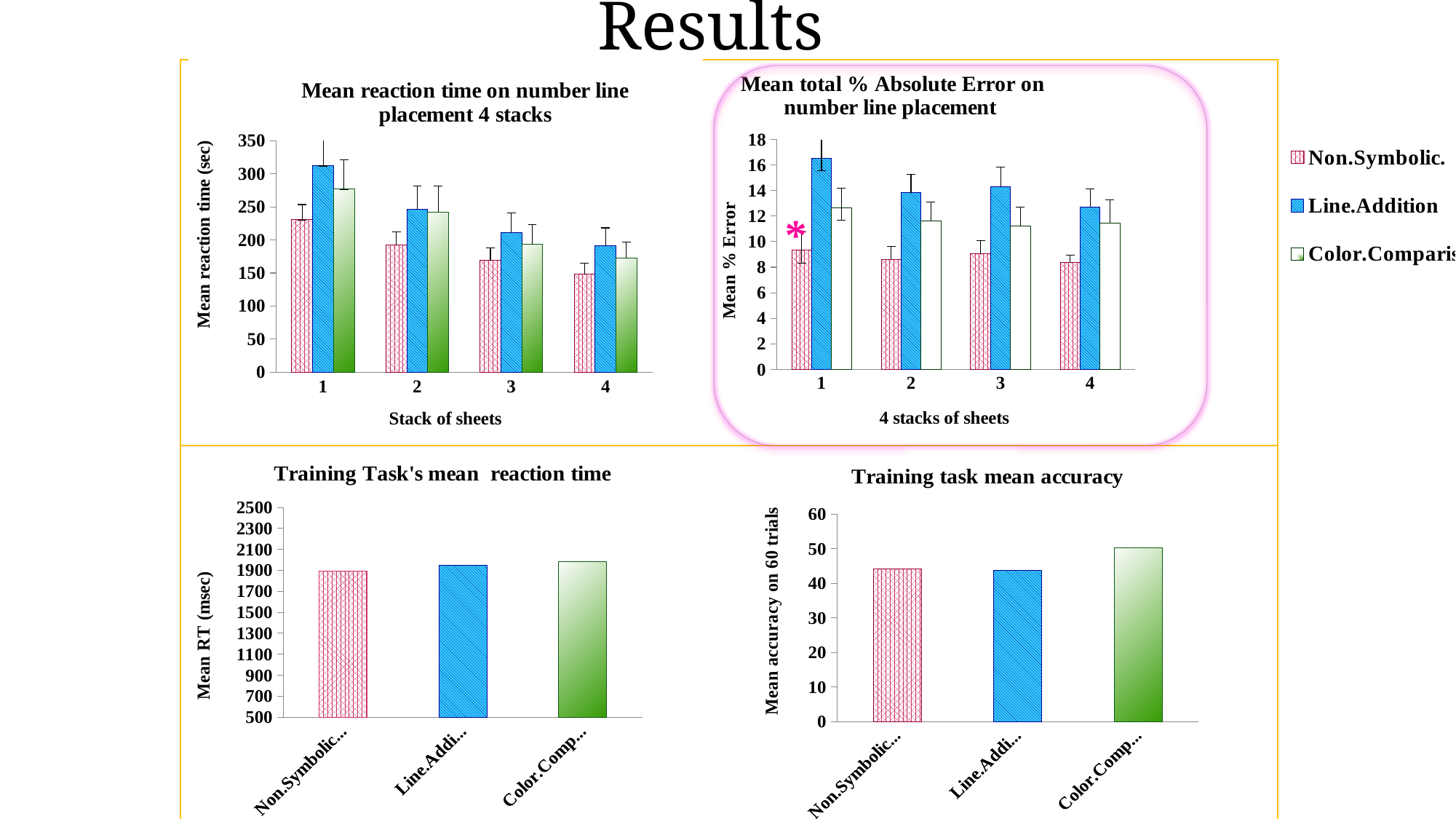
In the 'Mean reaction time on number line placement 4 stacks' chart, is the Non.Symbolic value at stack 4 greater or less than 200? less In the 'Training task mean accuracy' chart, is the Line.Addition value greater or less than 50? less In the 'Mean reaction time on number line placement 4 stacks' chart, which series has the highest bar at stack 1? Line.Addition How many series does the legend on the slide list? 3 In the 'Mean total % Absolute Error on number line placement' chart, is the Non.Symbolic value at stack 1 greater or less than 10? less In the 'Mean reaction time on number line placement 4 stacks' chart, do the Non.Symbolic values rise or fall from stack 1 to stack 4? fall In the 'Training task mean accuracy' chart, which condition has the highest bar? Color.Comparison In the 'Training Task's mean reaction time' chart, which condition has the lowest bar? Non.Symbolic In the 'Mean total % Absolute Error on number line placement' chart, which series has the highest bar at stack 1? Line.Addition How many stack categories are shown on the x axis of the 'Mean reaction time on number line placement 4 stacks' chart? 4